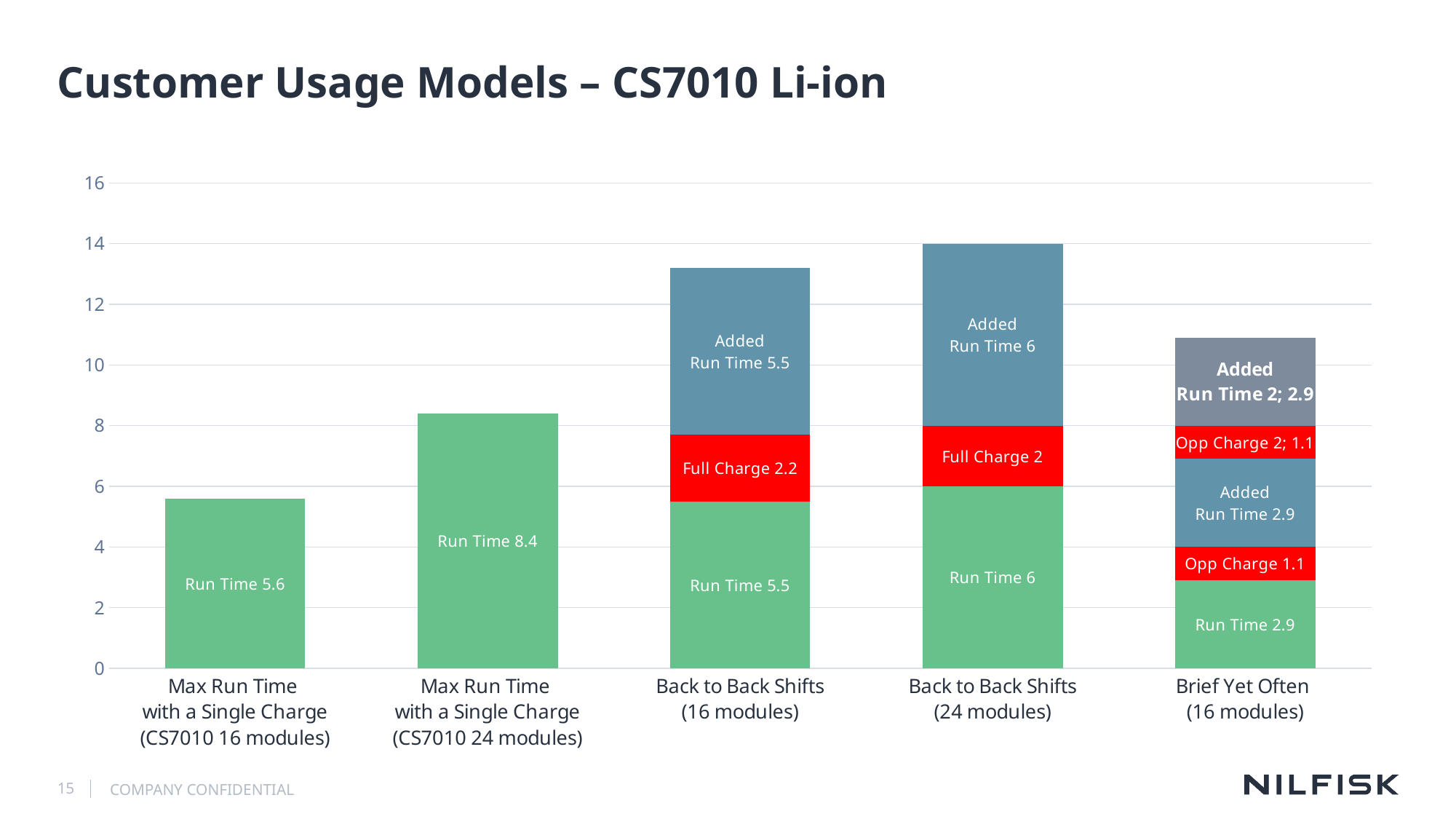
What is the Opp Charge value in the Brief Yet Often (16 modules) bar? 1.1 What is the Run Time value for Max Run Time with a Single Charge (CS7010 16 modules)? 5.6 How many categories are shown on the x axis? 5 Is the Full Charge value larger for Back to Back Shifts (16 modules) or Back to Back Shifts (24 modules)? Back to Back Shifts (16 modules) What is the total height of the Back to Back Shifts (16 modules) stacked bar? 13.2 What is the Added Run Time value for Back to Back Shifts (24 modules)? 6 What is the Full Charge value for Back to Back Shifts (16 modules)? 2.2 Which category has the shortest bar overall? Max Run Time with a Single Charge (CS7010 16 modules) What is the Run Time value for Max Run Time with a Single Charge (CS7010 24 modules)? 8.4 What is the difference in Run Time between the CS7010 24 modules and CS7010 16 modules Max Run Time bars? 2.8 What kind of chart is shown on the slide? Stacked bar chart Which category has the tallest bar overall? Back to Back Shifts (24 modules)